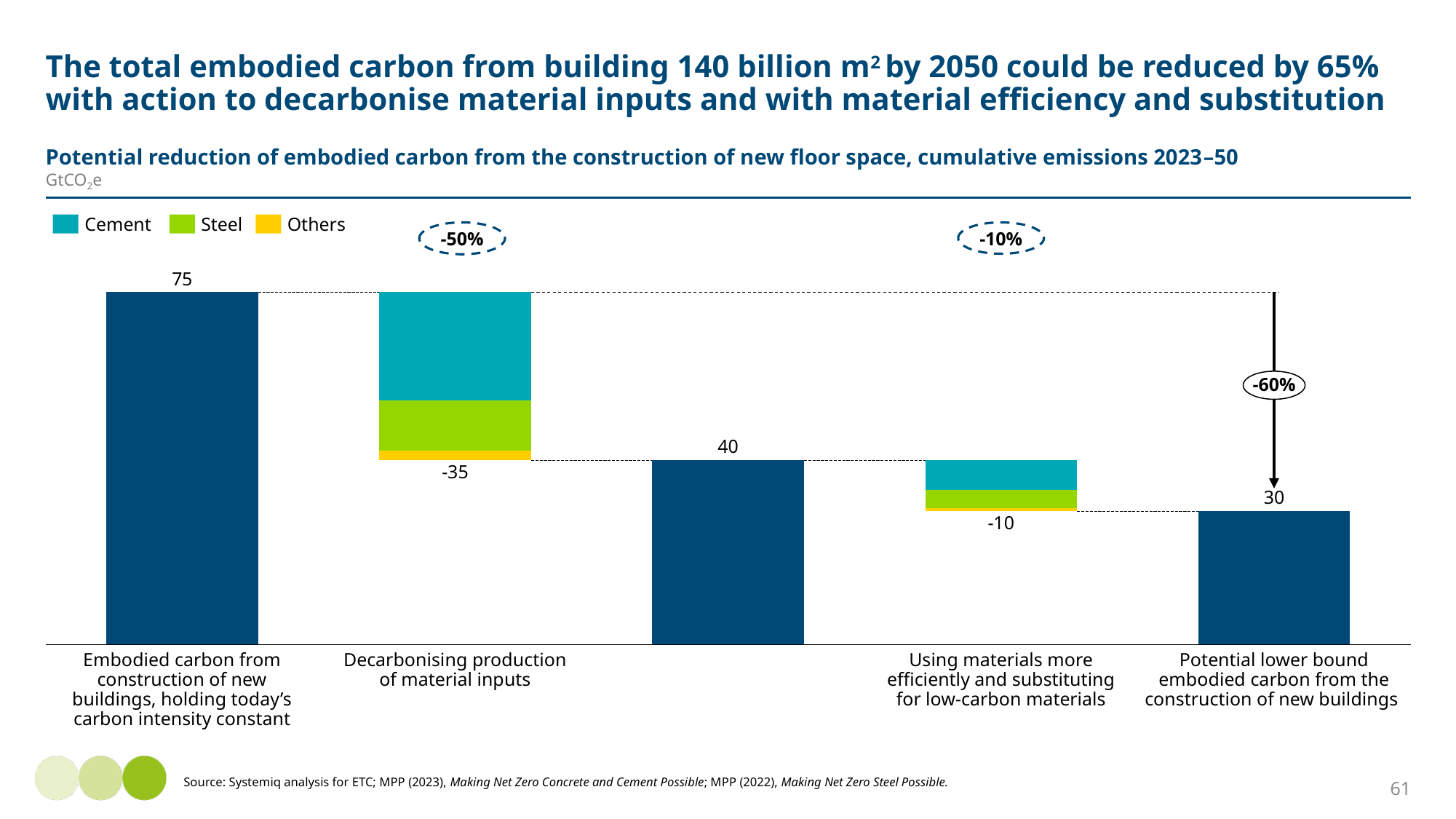
What is the value of the unlabelled middle bar between the two reduction steps? 40 How many series does the legend list? 3 What is the value for 'Potential lower bound embodied carbon from the construction of new buildings'? 30 Which category has the highest value in the chart? Embodied carbon from construction of new buildings, holding today's carbon intensity constant What is the value shown for 'Decarbonising production of material inputs'? -35 What is the difference between the starting value of 75 and the final value of 30? 45 What unit is the chart measured in? GtCO2e What is the value shown for 'Using materials more efficiently and substituting for low-carbon materials'? -10 Which is larger in magnitude: the reduction from 'Decarbonising production of material inputs' or from 'Using materials more efficiently and substituting for low-carbon materials'? Decarbonising production of material inputs What percentage reduction is shown in the dashed circle above 'Decarbonising production of material inputs'? -50% What overall percentage reduction is shown next to the arrow on the right of the chart? -60% What is the value for 'Embodied carbon from construction of new buildings, holding today's carbon intensity constant'? 75